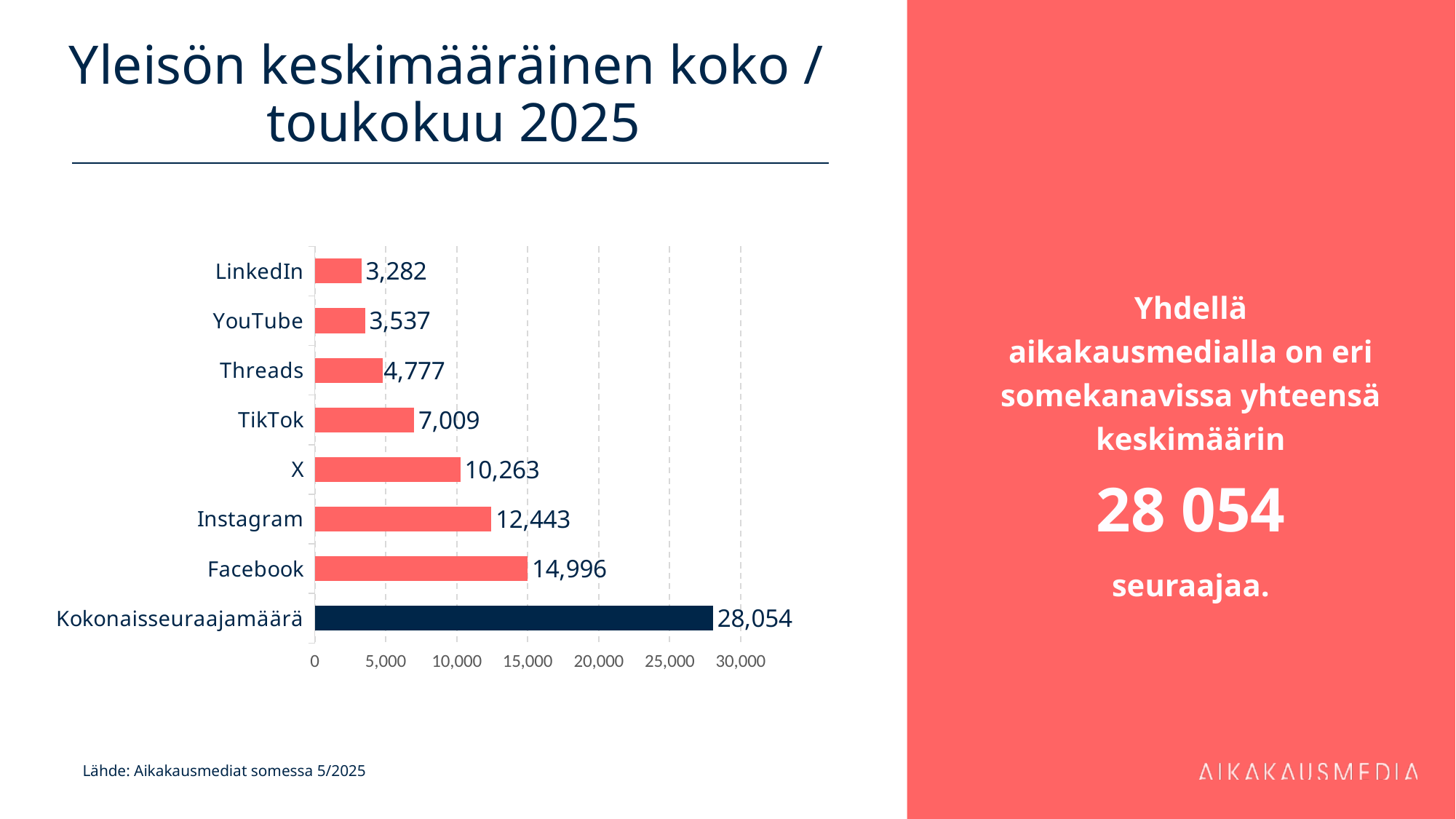
Which is larger, the value for YouTube or the value for Threads? Threads What is the value for TikTok? 7,009 What kind of chart is shown on the slide? Bar chart Which category has the lowest value? LinkedIn Is the value for Instagram greater or less than 10,000? greater How many categories are shown in the chart? 8 Which category has the highest value? Kokonaisseuraajamäärä What is the title of the slide? Yleisön keskimääräinen koko / toukokuu 2025 What is the difference between the values for Facebook and Instagram? 2,553 What is the value for Facebook? 14,996 What is the value for Kokonaisseuraajamäärä? 28,054 What is the difference between the values for X and TikTok? 3,254